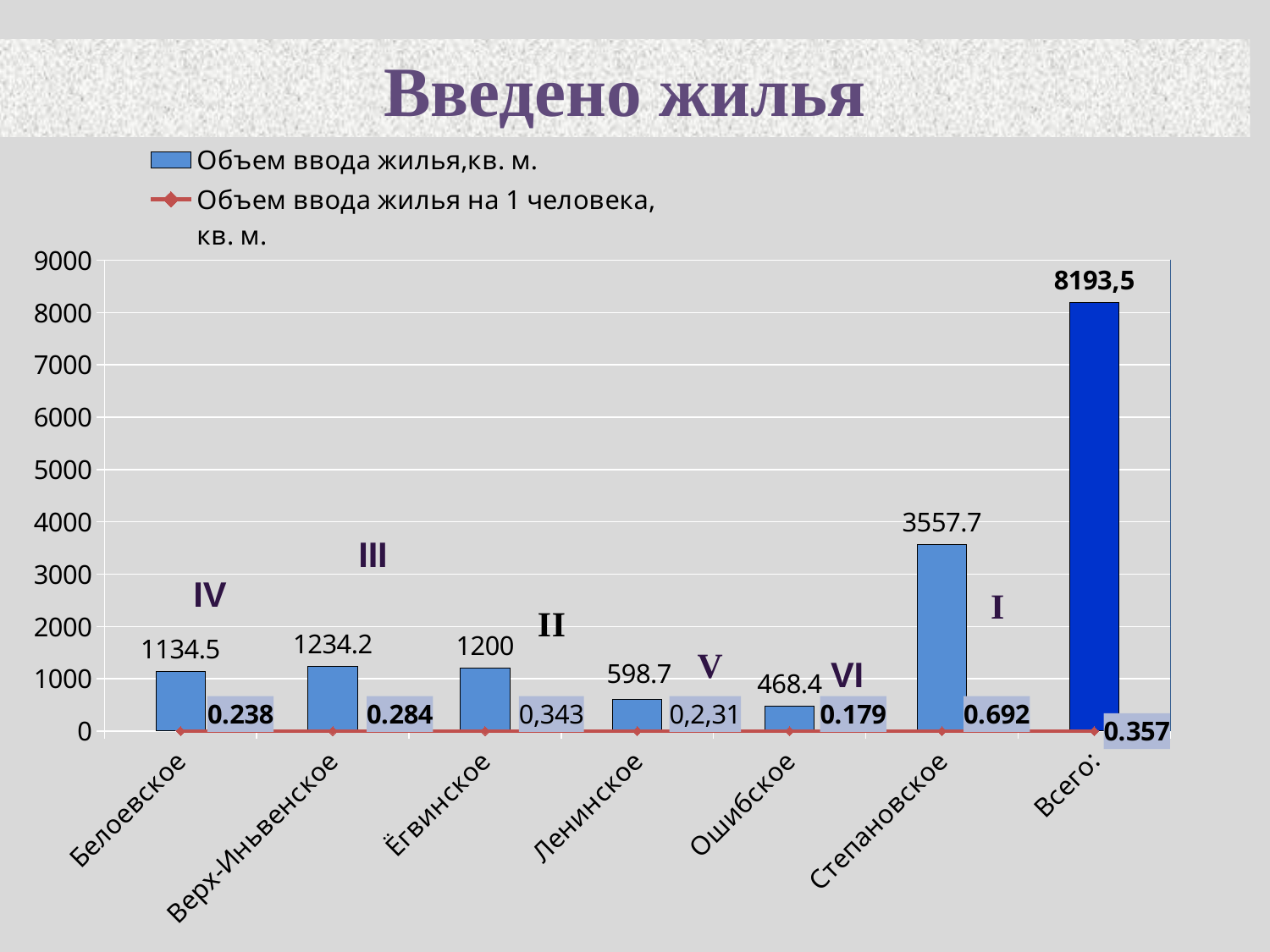
What is the value of Объем ввода жилья на 1 человека, кв. м. for Степановское? 0.692 What is the value of Объем ввода жилья на 1 человека, кв. м. for Всего:? 0.357 How many series does the legend list? 2 What is the difference in Объем ввода жилья, кв. м. between Верх-Иньвенское and Ёгвинское? 34.2 Excluding the Всего: total, which category has the highest Объем ввода жилья, кв. м.? Степановское Which category has the lowest Объем ввода жилья, кв. м.? Ошибское What is the value of Объем ввода жилья, кв. м. for Ошибское? 468.4 What is the value of Объем ввода жилья, кв. м. for Степановское? 3557.7 What is the value of Объем ввода жилья, кв. м. for Белоевское? 1134.5 What type of chart is shown on the slide? combination bar and line chart What is the title of the slide? Введено жилья Which has a larger Объем ввода жилья на 1 человека, кв. м.: Белоевское or Верх-Иньвенское? Верх-Иньвенское